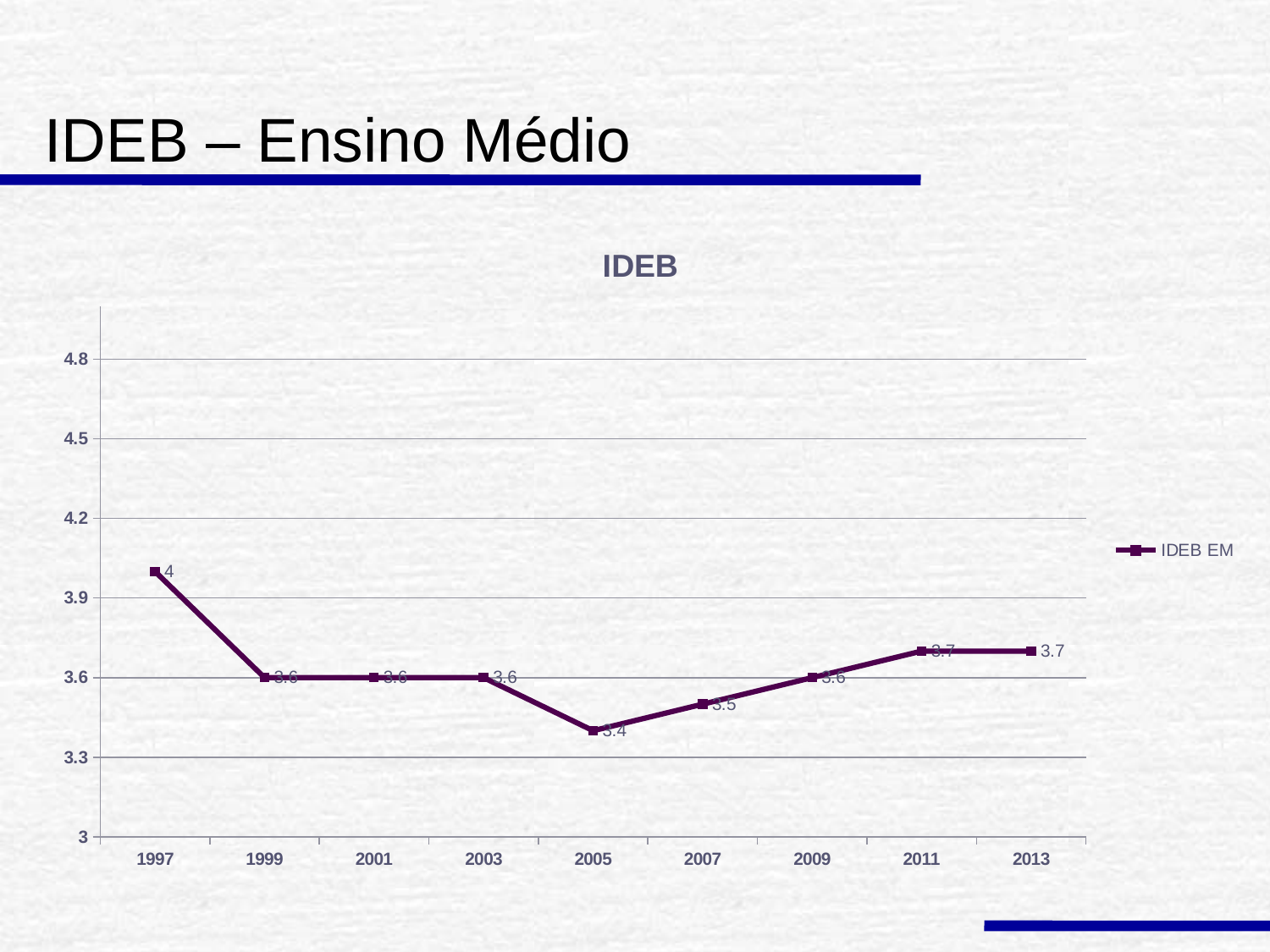
What is the difference between the IDEB EM value in 1997 and in 2005? 0.6 What kind of chart is shown? line chart What is the IDEB EM value for 1997? 4 How many years are plotted on the x axis? 9 What is the title of the chart? IDEB Is the IDEB EM value for 1997 greater or less than 3.9? greater What is the IDEB EM value for 2007? 3.5 Which year has the highest IDEB EM value? 1997 What is the IDEB EM value for 2005? 3.4 Which year has a larger IDEB EM value, 2009 or 2011? 2011 What is the IDEB EM value for 2013? 3.7 Which year has the lowest IDEB EM value? 2005